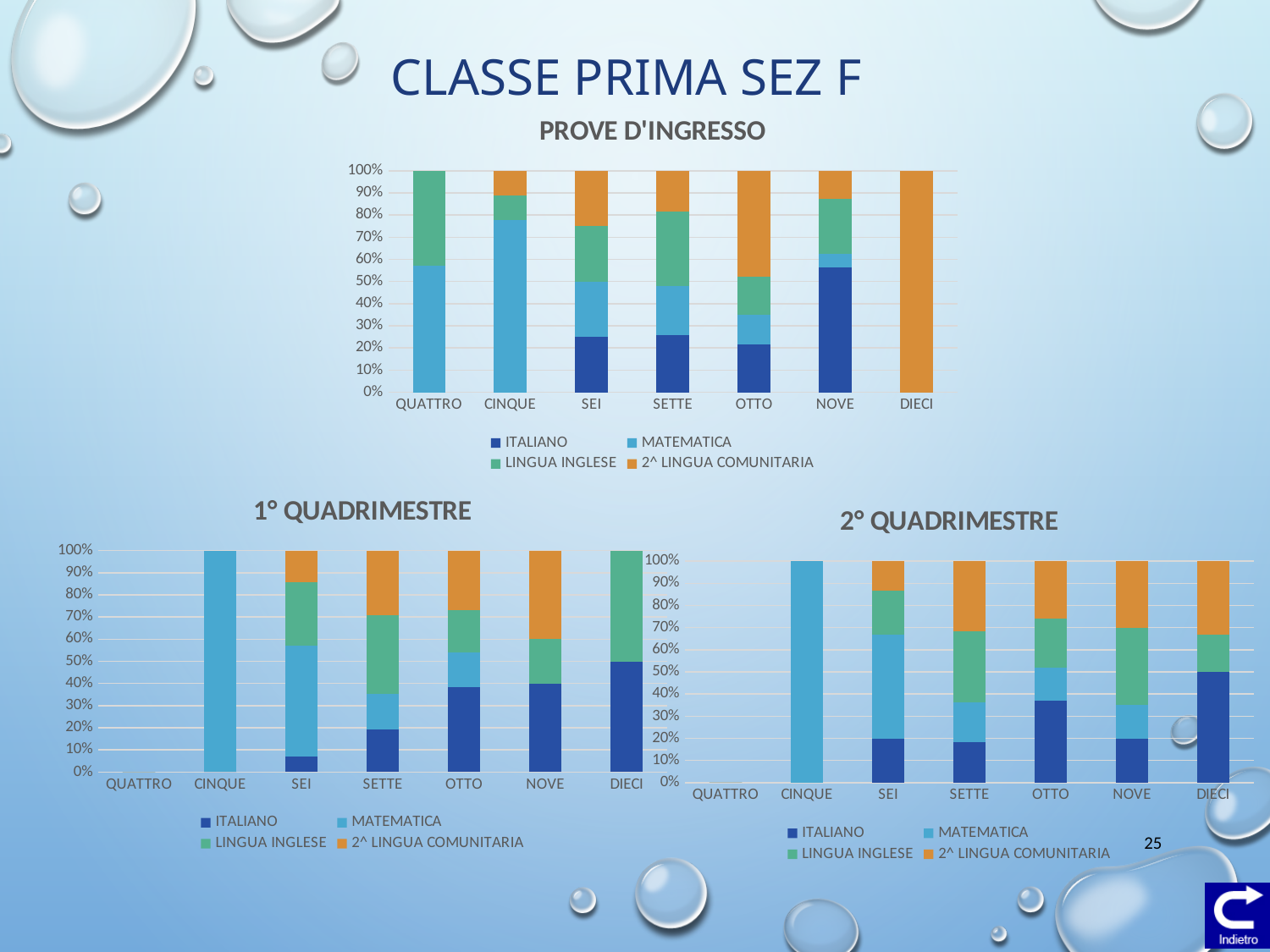
What is the title of the chart at the top of the slide? PROVE D'INGRESSO In the '2° QUADRIMESTRE' chart, is the ITALIANO value for OTTO greater or less than 30%? greater In the 'PROVE D'INGRESSO' chart, is the ITALIANO value for NOVE greater or less than 50%? greater In the 'PROVE D'INGRESSO' chart, is the ITALIANO value for OTTO greater or less than 30%? less In the '2° QUADRIMESTRE' chart, which series is shown in orange according to the legend? 2^ LINGUA COMUNITARIA What kind of chart is the 'PROVE D'INGRESSO' chart? Stacked bar chart In the 'PROVE D'INGRESSO' chart, which category has a larger ITALIANO value, NOVE or SEI? NOVE How many categories are shown on the x axis of the '1° QUADRIMESTRE' chart? 7 How many series does the legend of the '2° QUADRIMESTRE' chart list? 4